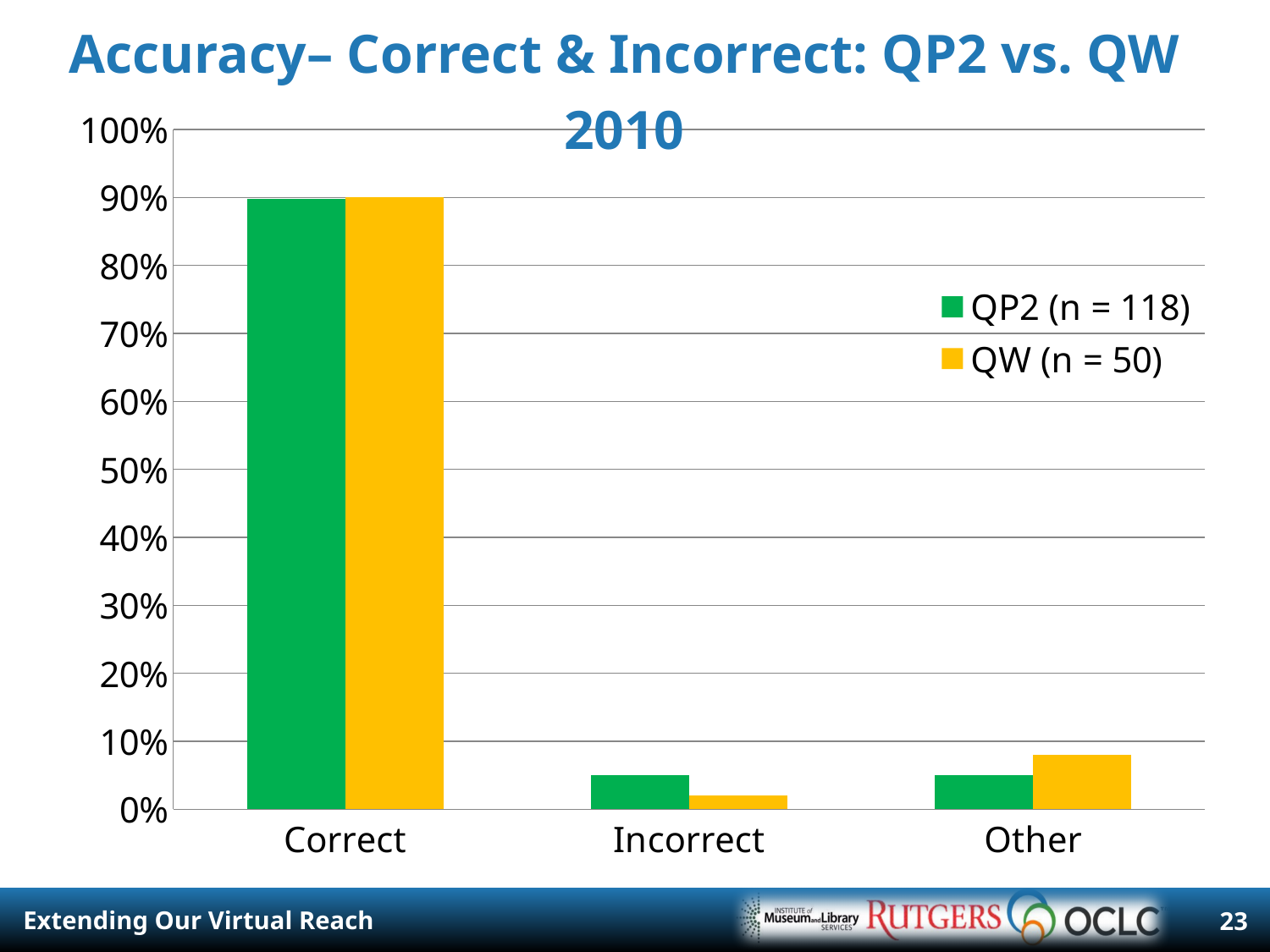
What colour represents the QW (n = 50) series? Yellow How many categories are shown on the x axis? 3 Which category has the lowest value for QW (n = 50)? Incorrect For the Other category, which series has the larger value, QP2 (n = 118) or QW (n = 50)? QW (n = 50) Is the value for QW (n = 50) in the Other category greater or less than 10%? less Which category has the highest value for QW (n = 50)? Correct For the Incorrect category, which series has the larger value, QP2 (n = 118) or QW (n = 50)? QP2 (n = 118) How many series does the legend list? 2 Which category has the highest value for QP2 (n = 118)? Correct What are the two series listed in the legend? QP2 (n = 118) and QW (n = 50) Is the value for QP2 (n = 118) in the Correct category greater or less than 80%? greater What kind of chart is shown on the slide? Bar chart